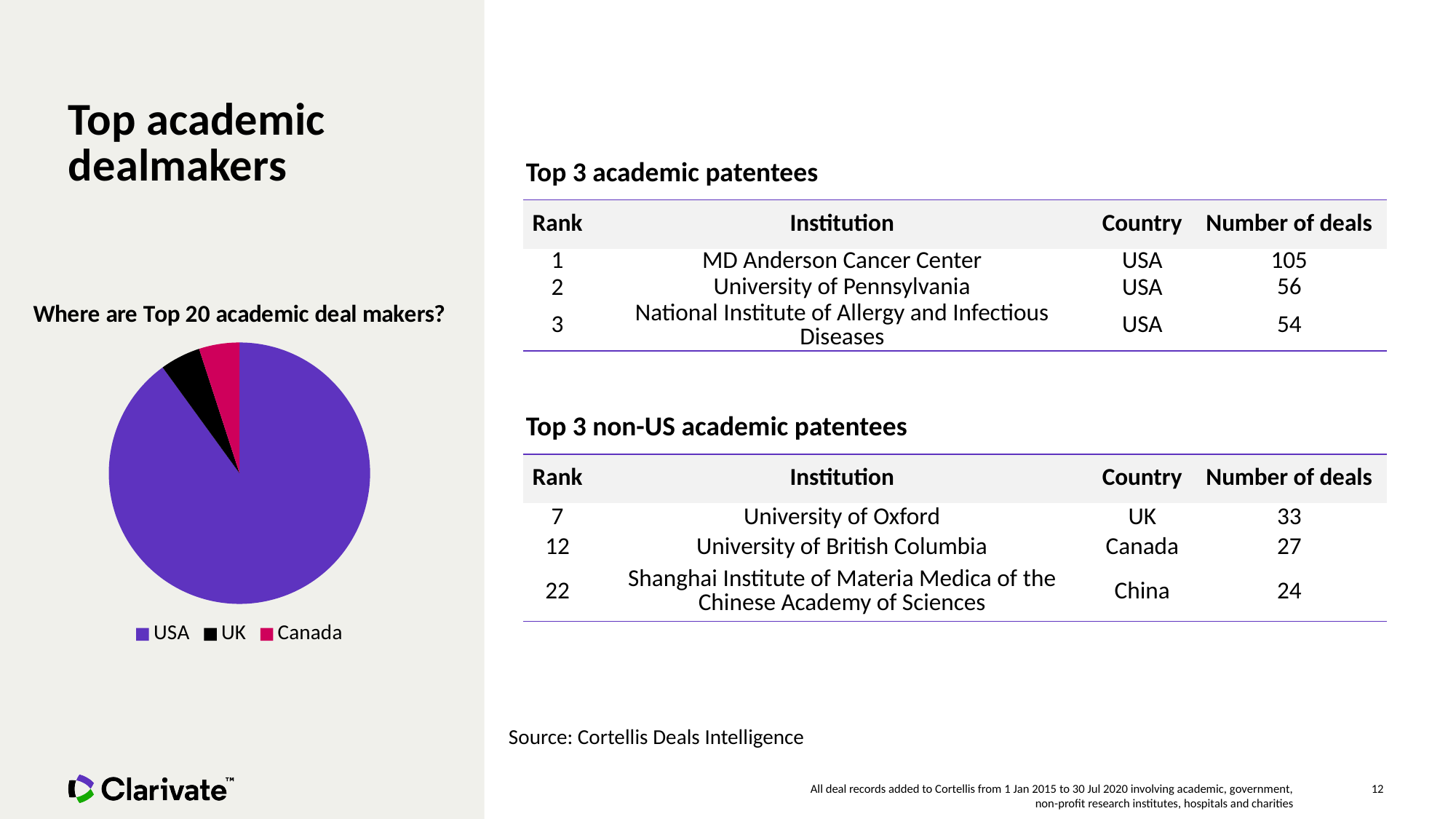
Which country has the largest slice of the pie chart? USA How many entries does the pie chart's legend list? 3 What is the title of the pie chart? Where are Top 20 academic deal makers? What kind of chart is shown on the slide? pie chart How many categories does the pie chart show? 3 Which slice is larger in the pie chart, Canada or USA? USA Which slice is larger in the pie chart, USA or UK? USA Which country is represented by the black slice in the pie chart? UK